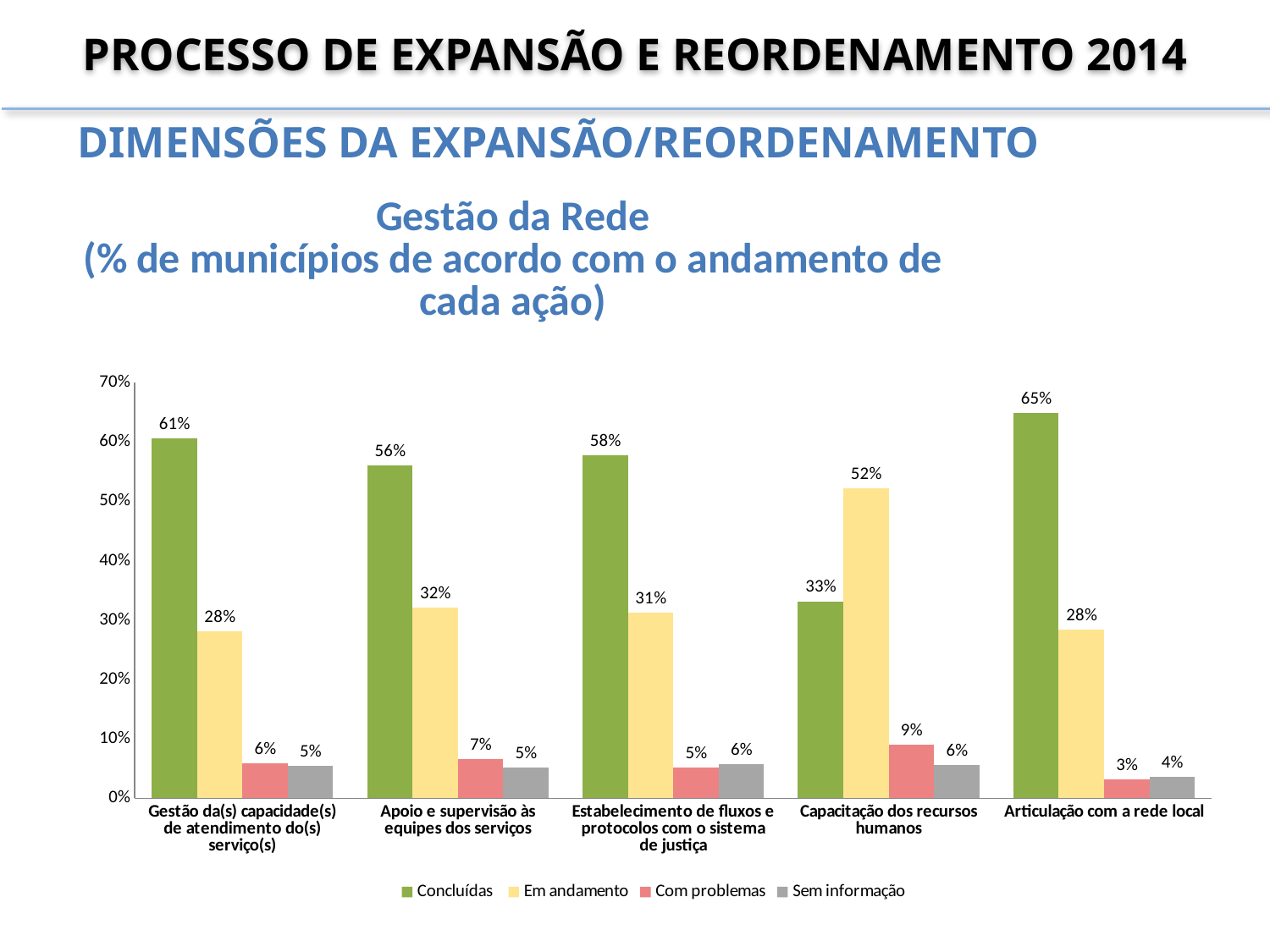
What is the value of 'Com problemas' for 'Apoio e supervisão às equipes dos serviços'? 7% Is the 'Concluídas' value for 'Estabelecimento de fluxos e protocolos com o sistema de justiça' greater or less than 50%? greater Which category has the highest 'Concluídas' value? Articulação com a rede local What kind of chart is shown on the slide? Bar chart What is the value of 'Concluídas' for 'Articulação com a rede local'? 65% Which is larger for 'Capacitação dos recursos humanos': 'Concluídas' or 'Em andamento'? Em andamento Which series is shown in green? Concluídas How many categories are shown on the x axis? 5 What is the value of 'Em andamento' for 'Capacitação dos recursos humanos'? 52% Which category has the lowest 'Concluídas' value? Capacitação dos recursos humanos How many series does the legend list? 4 What is the difference between the 'Concluídas' and 'Em andamento' values for 'Gestão da(s) capacidade(s) de atendimento do(s) serviço(s)'? 33%